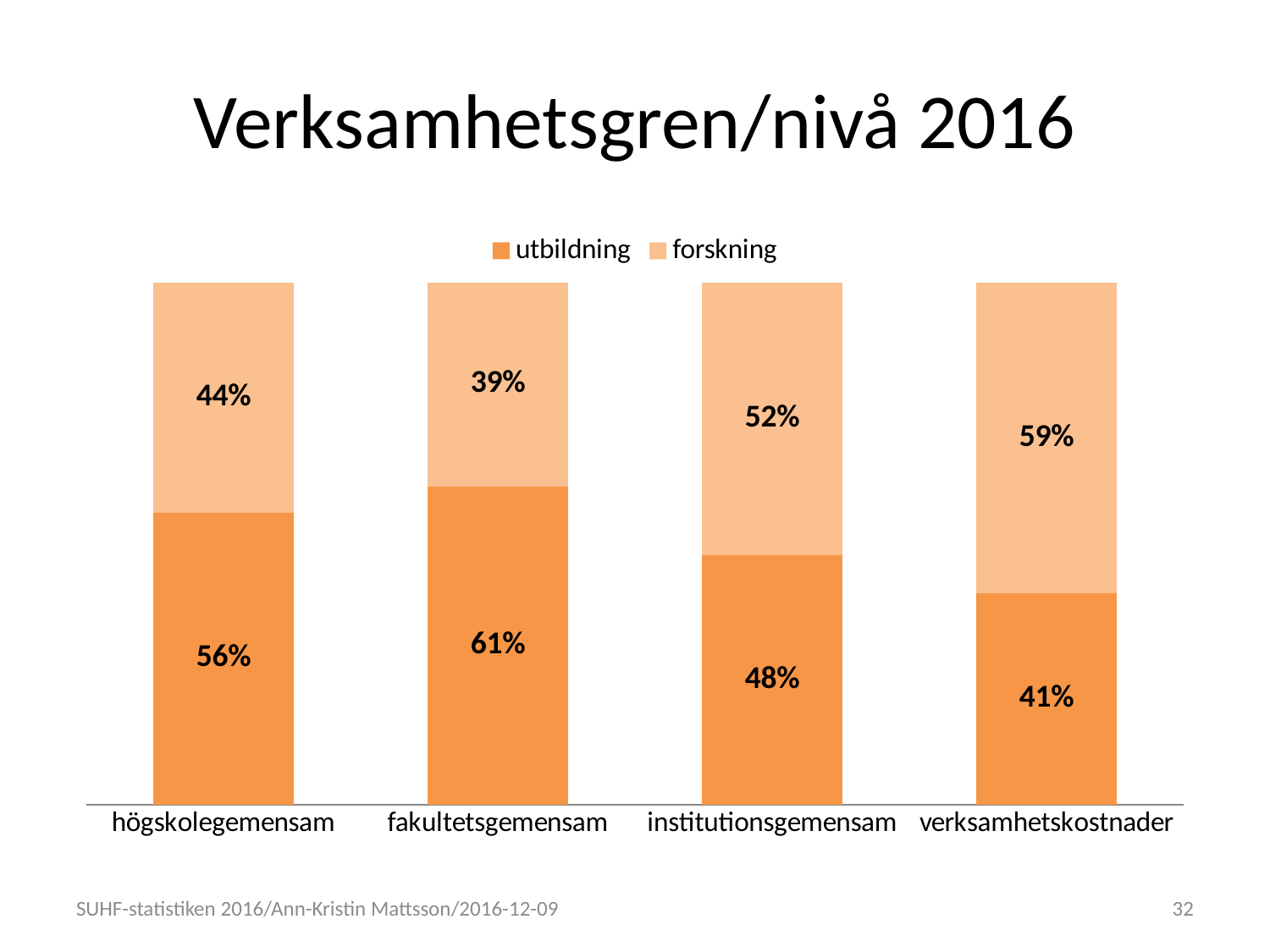
Which category has the lowest forskning share? fakultetsgemensam What is the forskning share for verksamhetskostnader? 59% How many series does the legend list? 2 Which category has the highest utbildning share? fakultetsgemensam What is the utbildning share for högskolegemensam? 56% What kind of chart is shown? stacked bar chart What is the utbildning share for institutionsgemensam? 48% How many categories are shown on the x axis? 4 What is the difference between the utbildning and forskning shares for verksamhetskostnader? 18% What is the title of the chart? Verksamhetsgren/nivå 2016 Which is larger for institutionsgemensam, utbildning or forskning? forskning What is the forskning share for fakultetsgemensam? 39%